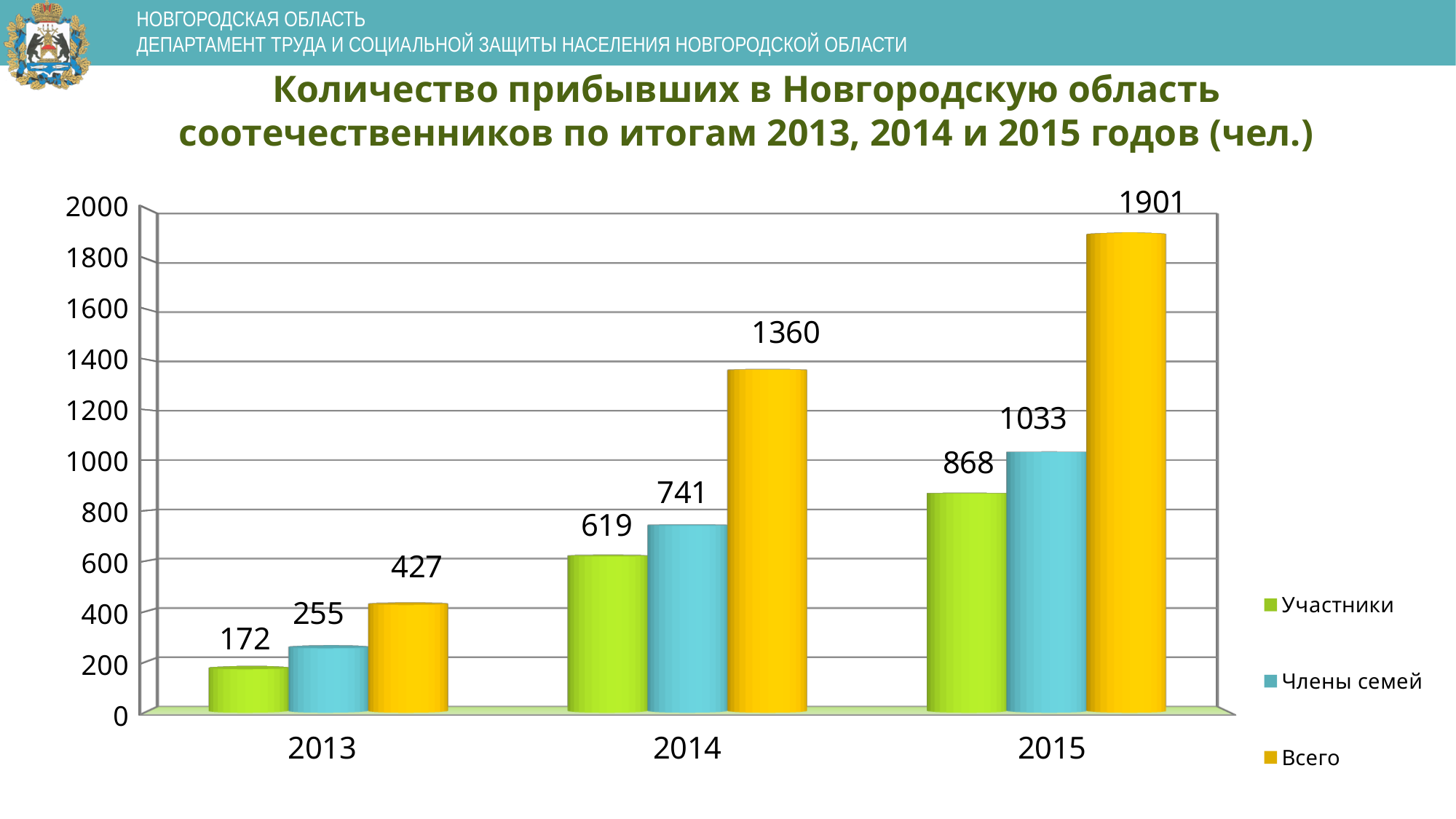
What is the value for Участники in 2013? 172 How many series does the legend list? 3 How many years are shown on the x axis? 3 What kind of chart is shown on the slide? bar chart What is the value for Всего in 2015? 1901 Do the values for Члены семей rise or fall from 2013 to 2015? rise What is the difference between Всего in 2015 and Всего in 2014? 541 Which is larger: Члены семей in 2015 or Участники in 2015? Члены семей in 2015 Which year has the lowest value for Участники? 2013 Which year has the highest value for Всего? 2015 What is the value for Члены семей in 2014? 741 Is the value for Всего in 2014 greater or less than 1200? greater